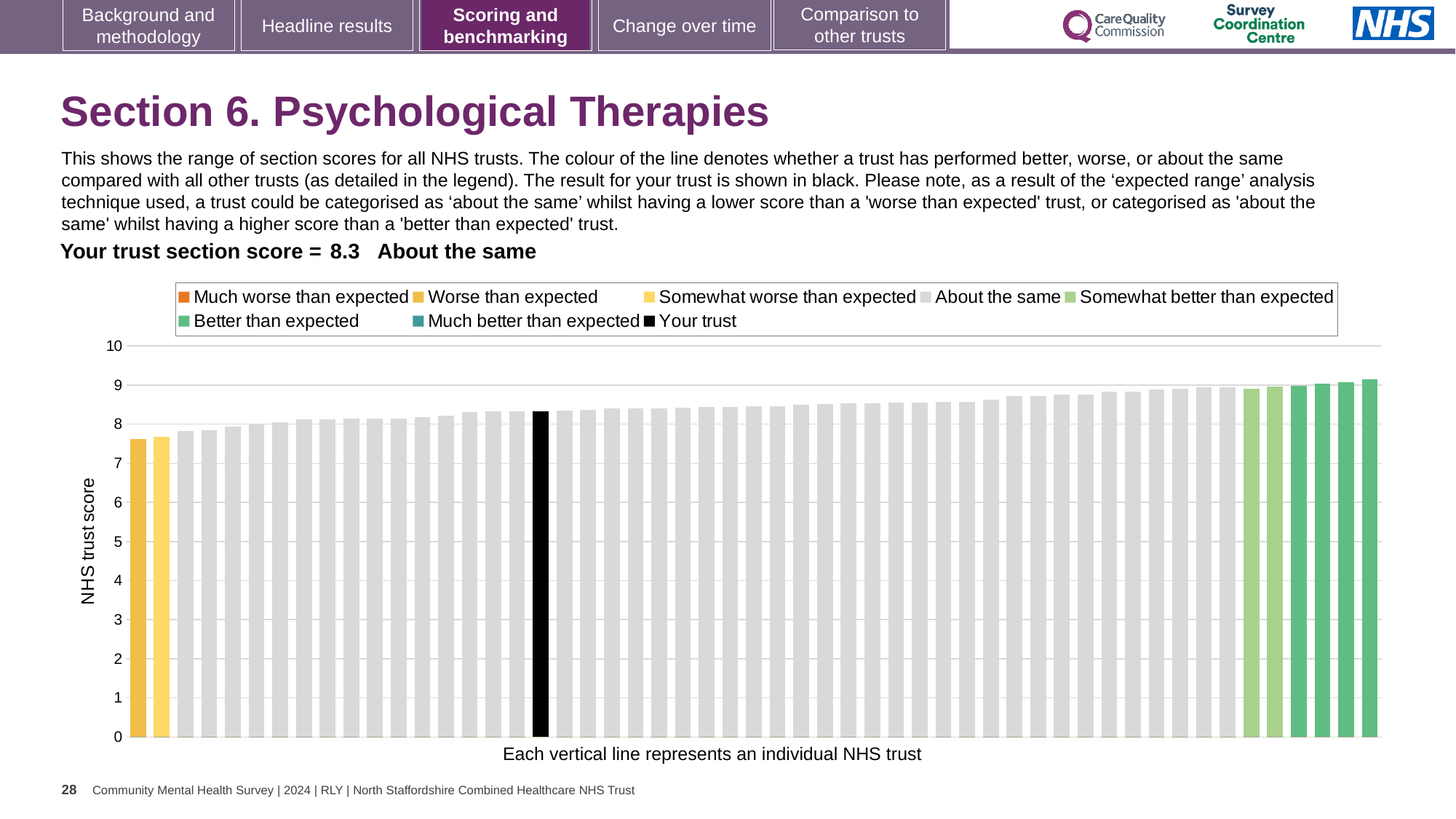
What is the section score for your trust shown on the slide? 8.3 What colour is the bar representing your trust? black How many bars are coloured as 'Better than expected' (dark green)? 4 Is the value of the lowest bar in the chart greater or less than 8? less Which is larger, the leftmost bar or the rightmost bar? the rightmost bar What kind of chart is shown on the slide? bar chart Is the value of the highest bar in the chart greater or less than 8? greater How many entries does the chart legend list? 8 How many bars are coloured as 'Worse than expected' (yellow)? 1 Do the bar values rise or fall from left to right along the x axis? rise Is the value for your trust (the black bar) greater or less than 8? greater What is the label on the y axis of the chart? NHS trust score